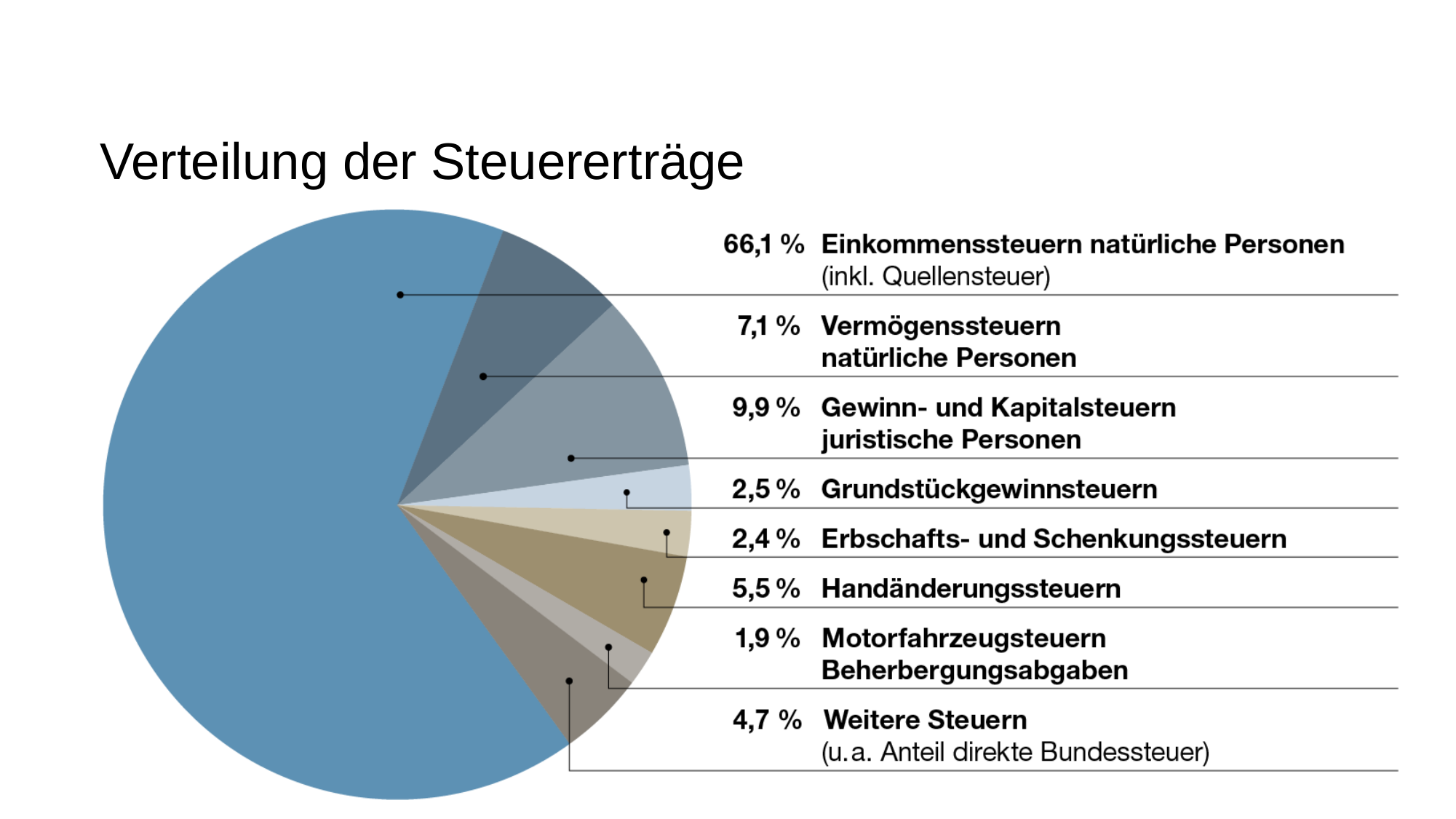
Which category has the largest share of the pie? Einkommenssteuern natürliche Personen (inkl. Quellensteuer) What is the title of the chart? Verteilung der Steuererträge What type of chart is shown on the slide? pie chart How many slices does the pie chart have? 8 Which category has the smallest share of the pie? Motorfahrzeugsteuern Beherbergungsabgaben Which is larger, Handänderungssteuern or Weitere Steuern? Handänderungssteuern What is the value for Vermögenssteuern natürliche Personen? 7,1 % What share of the pie is Einkommenssteuern natürliche Personen (inkl. Quellensteuer)? 66,1 % What is the value for Handänderungssteuern? 5,5 % What is the value for Weitere Steuern (u.a. Anteil direkte Bundessteuer)? 4,7 % What is the value for Gewinn- und Kapitalsteuern juristische Personen? 9,9 % What is the difference between Gewinn- und Kapitalsteuern juristische Personen and Vermögenssteuern natürliche Personen? 2,8 %